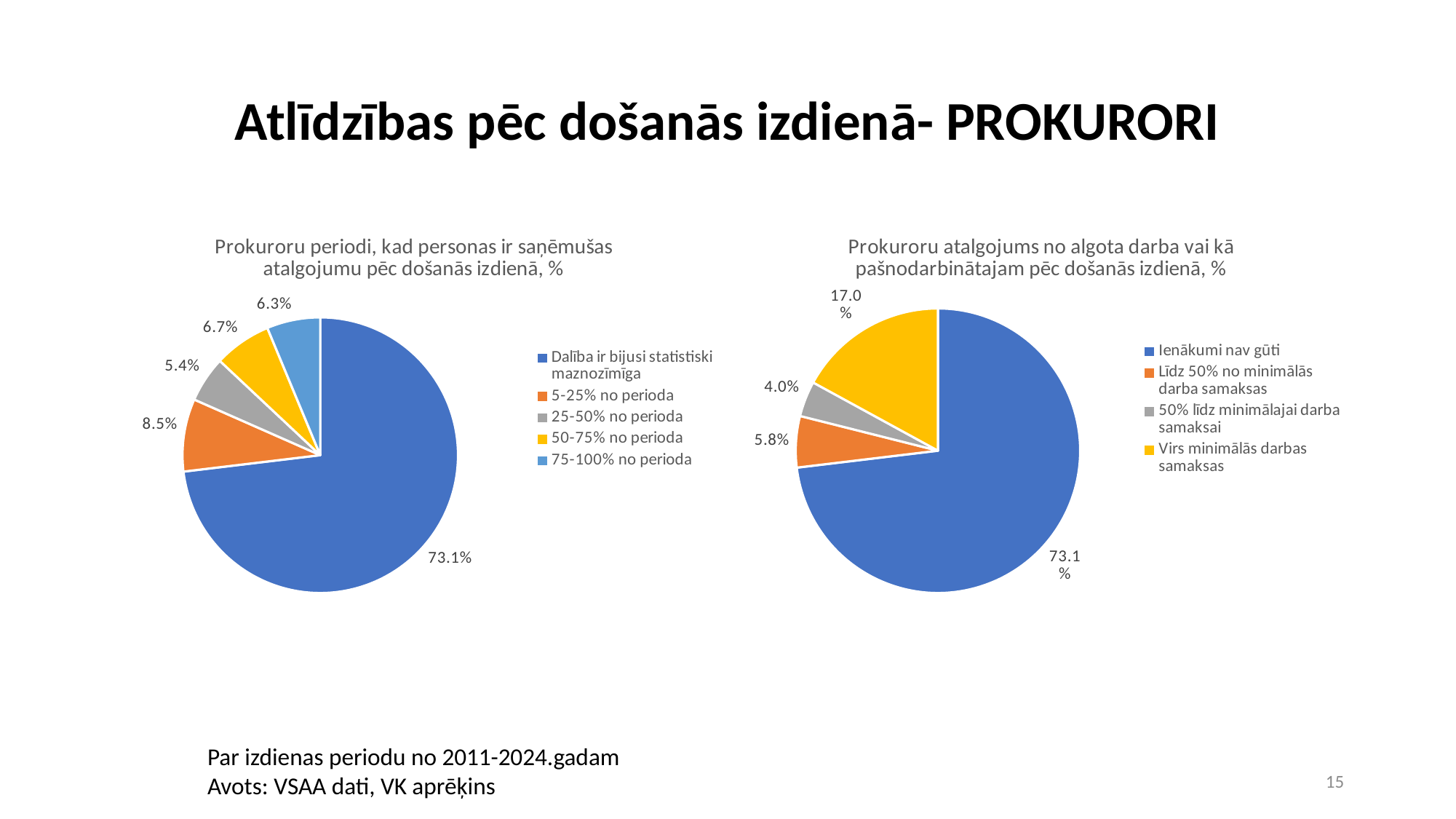
In the left chart (Prokuroru periodi...), how many categories does the legend list? 5 In the right chart (Prokuroru atalgojums...), what is the difference between 'Virs minimālās darbas samaksas' and 'Līdz 50% no minimālās darba samaksas'? 11.2% In the right chart (Prokuroru atalgojums...), what is the value for '50% līdz minimālajai darba samaksai'? 4.0% In the left chart (Prokuroru periodi...), what is the value for '75-100% no perioda'? 6.3% What type of chart is used on the right side of the slide? Pie chart In the left chart (Prokuroru periodi...), what is the value for '5-25% no perioda'? 8.5% In the left chart (Prokuroru periodi...), what is the difference between '5-25% no perioda' and '50-75% no perioda'? 1.8% In the right chart (Prokuroru atalgojums no algota darba vai kā pašnodarbinātajam pēc došanās izdienā, %), what is the value for 'Virs minimālās darbas samaksas'? 17.0% In the left chart (Prokuroru periodi, kad personas ir saņēmušas atalgojumu pēc došanās izdienā, %), what is the value for 'Dalība ir bijusi statistiski maznozīmīga'? 73.1% In the right chart (Prokuroru atalgojums...), which is larger: 'Līdz 50% no minimālās darba samaksas' or '50% līdz minimālajai darba samaksai'? Līdz 50% no minimālās darba samaksas In the left chart (Prokuroru periodi...), which category has the smallest slice? 25-50% no perioda In the right chart (Prokuroru atalgojums...), which category has the largest slice? Ienākumi nav gūti